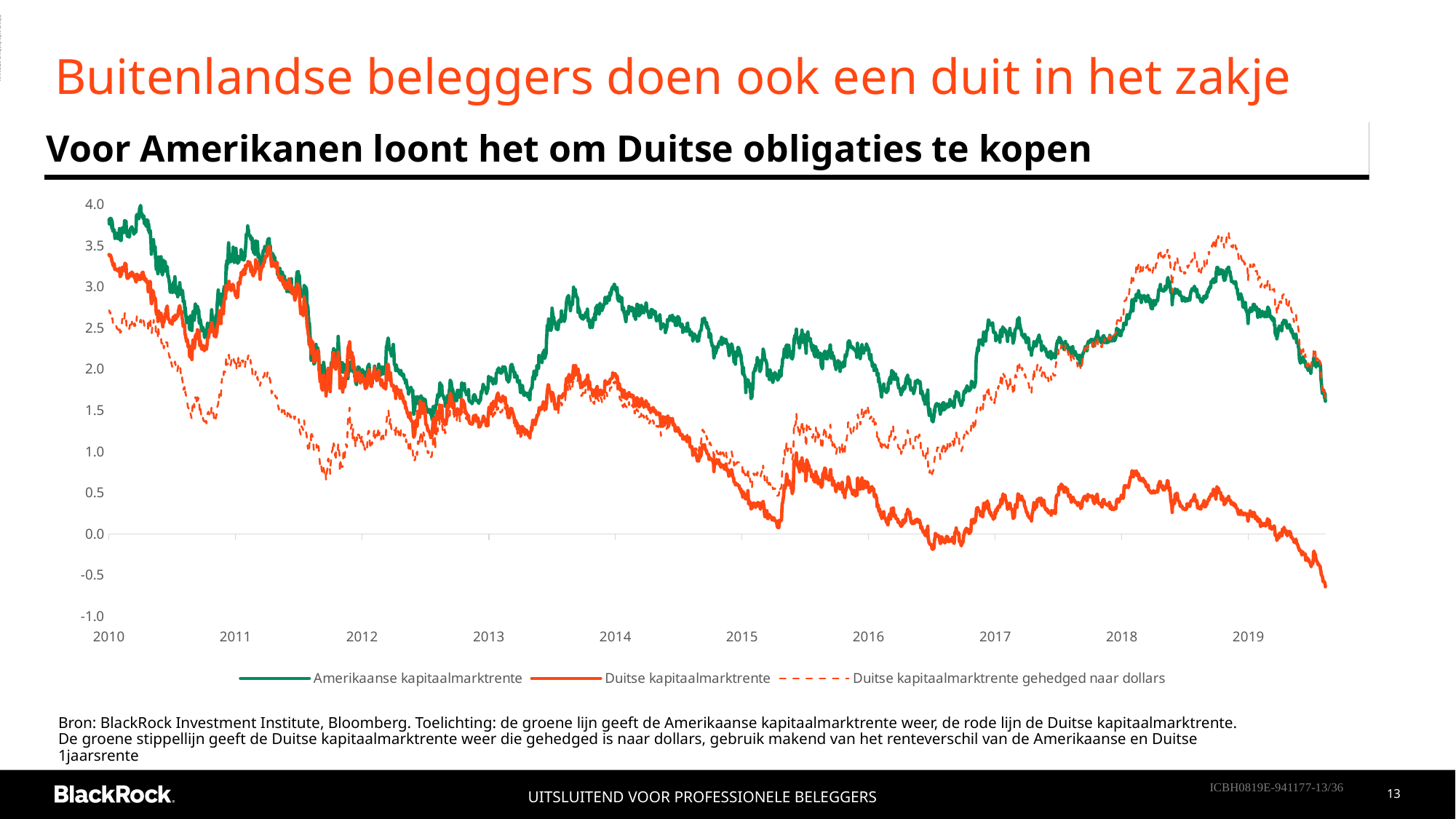
Is the value of Duitse kapitaalmarktrente at the end of the chart (2019) greater or less than 0.0? less Is the value of Amerikaanse kapitaalmarktrente at the end of the chart greater or less than 2.0? less Which series is drawn as a dashed line? Duitse kapitaalmarktrente gehedged naar dollars At the end of the chart in 2019, which is higher: Amerikaanse kapitaalmarktrente or Duitse kapitaalmarktrente? Amerikaanse kapitaalmarktrente Is the value of Amerikaanse kapitaalmarktrente at the start of 2010 greater or less than 3.5? greater What colour is the line for Amerikaanse kapitaalmarktrente? green Which series has the lowest value at the end of the chart? Duitse kapitaalmarktrente How many year labels are shown on the x axis? 10 What kind of chart is shown on the slide? line chart Does the Duitse kapitaalmarktrente overall rise or fall from 2010 to 2019? fall How many series does the legend list? 3